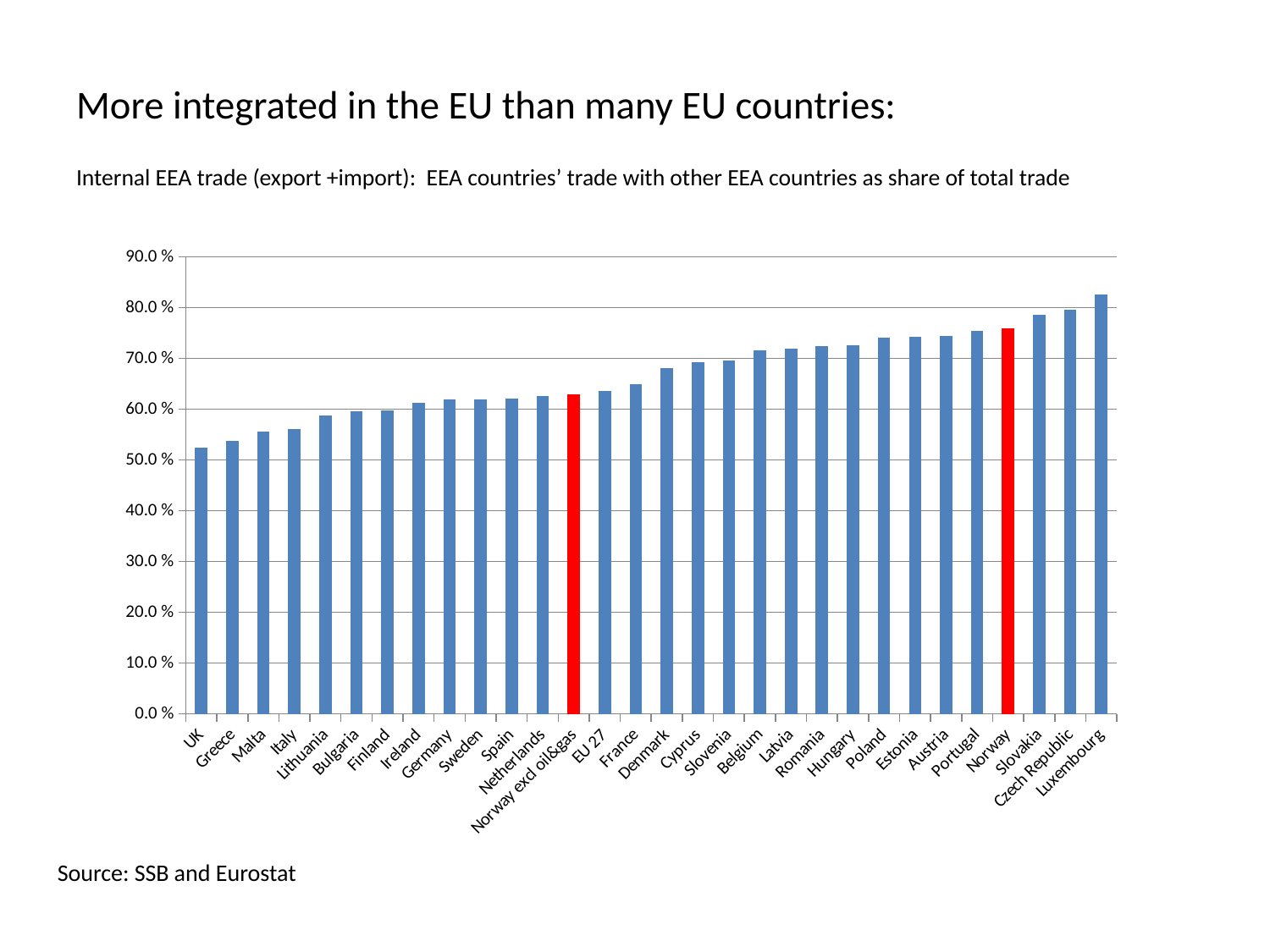
Which country has the lowest share of internal EEA trade? UK Which two bars are coloured red on the chart? Norway excl oil&gas and Norway What kind of chart is shown on the slide? bar chart Is the value for Norway greater or less than 70.0 %? greater Is the value for Greece greater or less than 50.0 %? greater Which country has the highest share of internal EEA trade? Luxembourg Which has a larger value, Norway or Germany? Norway Which has a larger value, Italy or Belgium? Belgium Do the values rise or fall moving from left to right along the x axis? rise Is the value for Luxembourg greater or less than 80.0 %? greater How many countries or groups are plotted on the chart? 30